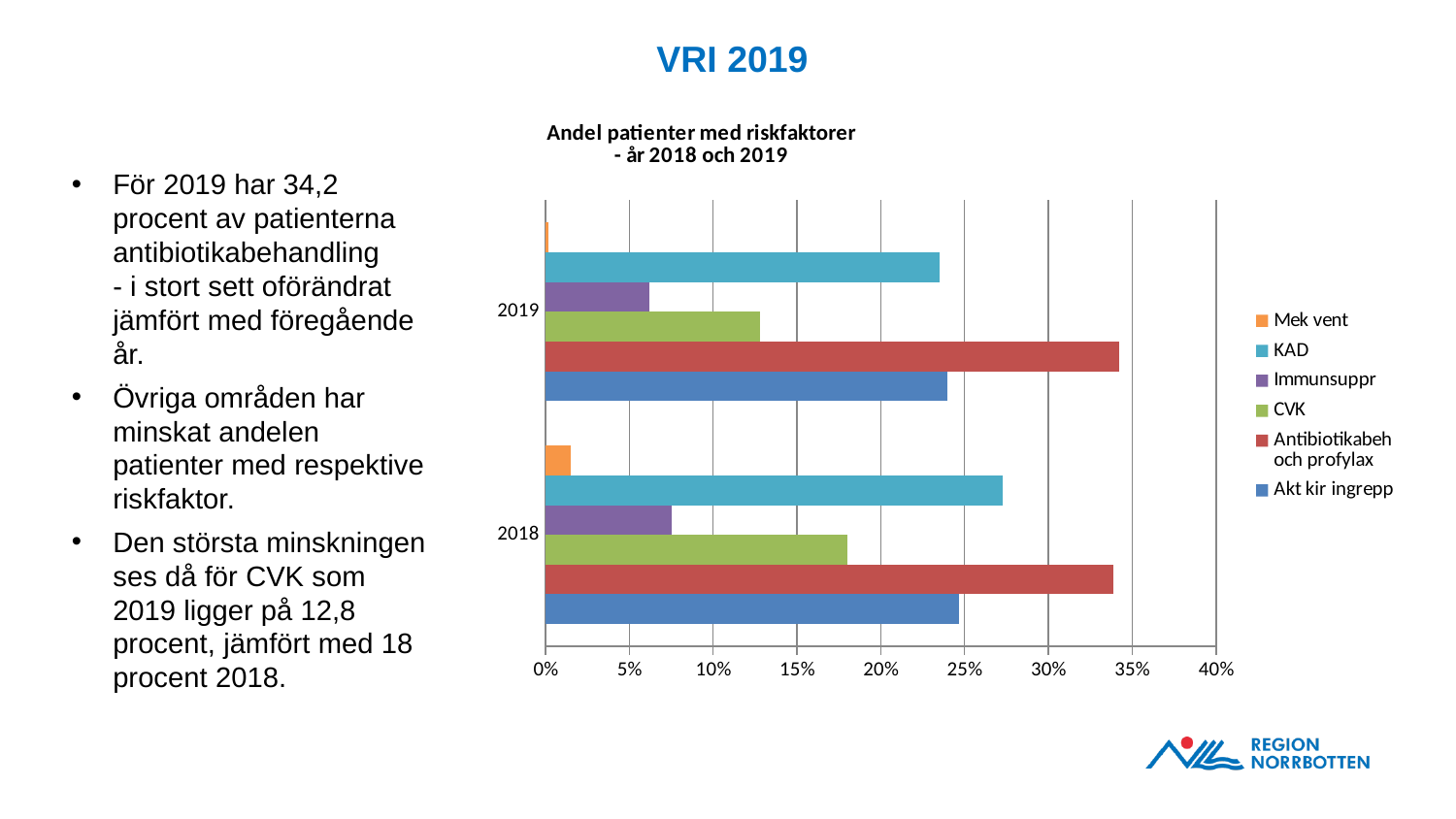
Is the value for CVK in 2019 greater or less than 15%? less Is the value for KAD in 2019 greater or less than 25%? less Which risk factor has the highest share of patients in 2019? Antibiotikabeh och profylax Which year has the larger value for KAD, 2018 or 2019? 2018 Which risk factor has the lowest share of patients in 2019? Mek vent How many year categories are shown on the chart's vertical axis? 2 Which year has the larger value for CVK, 2018 or 2019? 2018 Is the value for Antibiotikabeh och profylax in 2019 greater or less than 30%? greater How many series does the chart's legend list? 6 What kind of chart is shown on the slide? Bar chart What is the title of the chart? Andel patienter med riskfaktorer - år 2018 och 2019